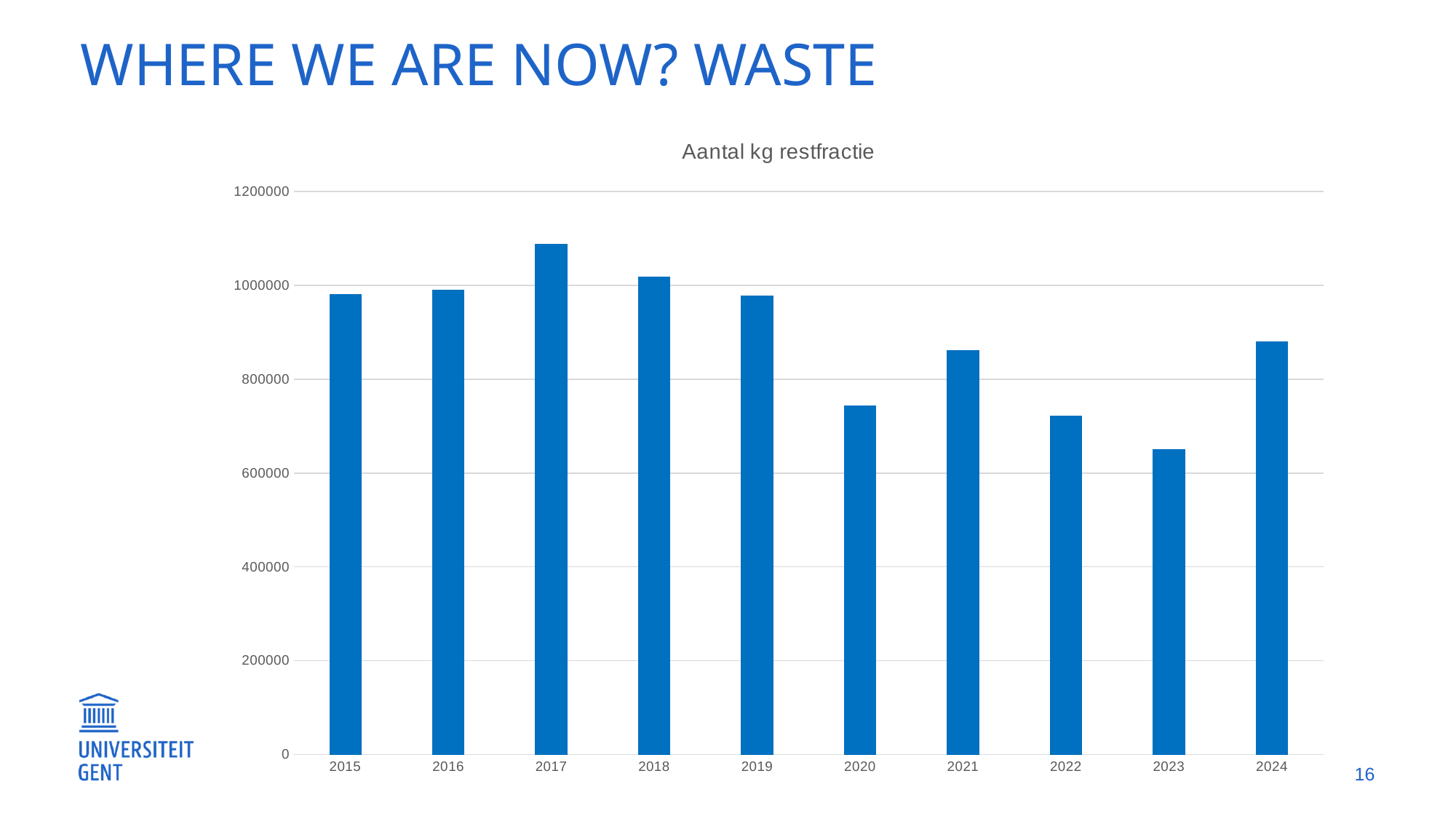
What kind of chart is shown on the slide? bar chart Which year has the larger value, 2022 or 2024? 2024 Which year has the larger value, 2021 or 2020? 2021 Is the value for 2023 greater or less than 600000? greater What is the title of the chart? Aantal kg restfractie How many years are shown on the x axis of the chart? 10 Do the values generally rise or fall from 2017 to 2023? fall Which year has the highest value in the chart? 2017 Is the value for 2020 greater or less than 800000? less Is the value for 2017 greater or less than 1000000? greater Which year has the lowest value in the chart? 2023